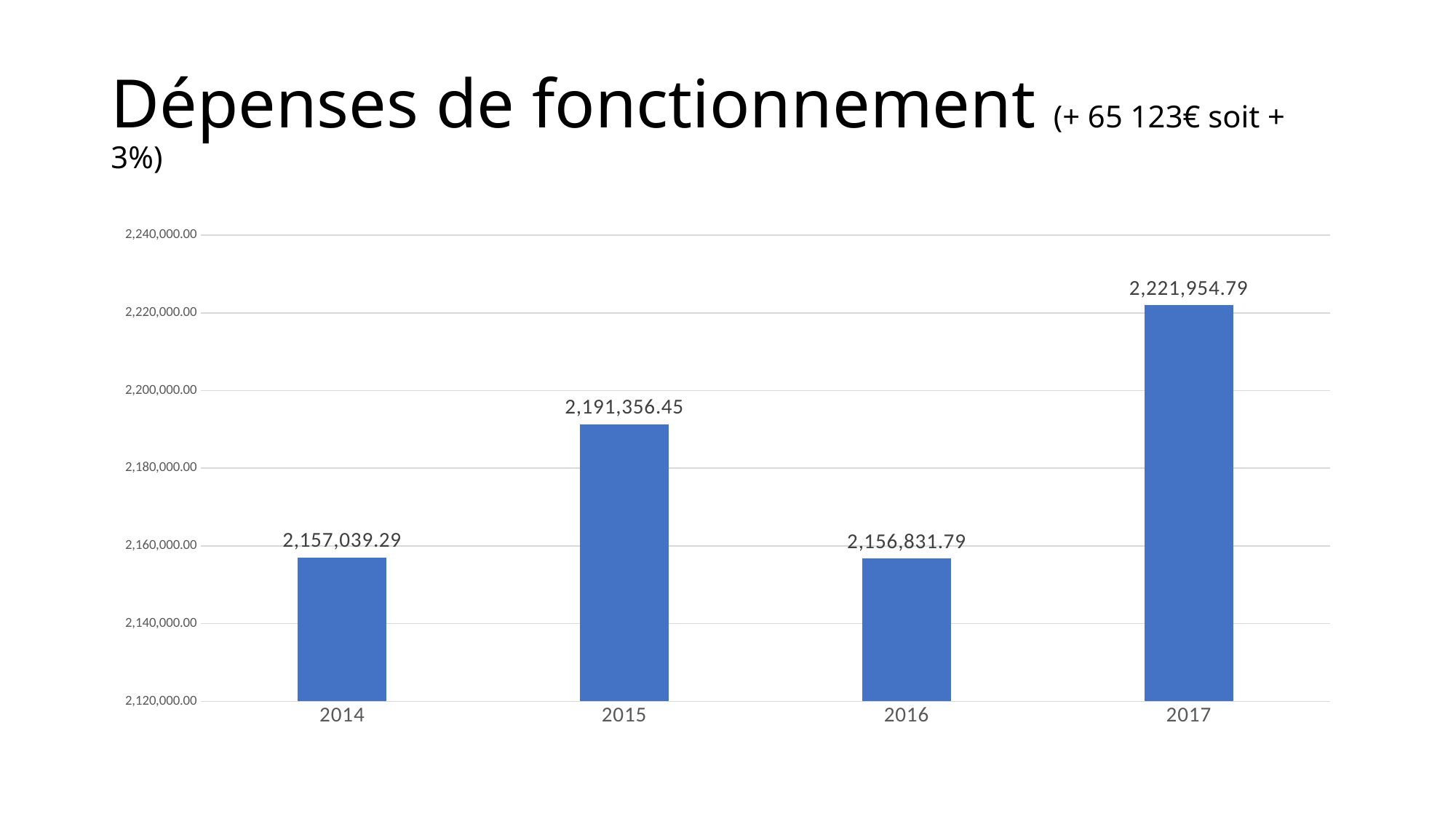
What is the value for 2016? 2,156,831.79 What is the difference between the values for 2017 and 2016? 65,123.00 What is the value for 2014? 2,157,039.29 What is the value for 2017? 2,221,954.79 Does the value rise or fall from 2016 to 2017? rise What kind of chart is shown on the slide? bar chart What is the difference between the values for 2015 and 2014? 34,317.16 Which is larger, the value for 2015 or the value for 2016? 2015 Which year has the highest value? 2017 What is the value for 2015? 2,191,356.45 How many years are shown on the x axis? 4 Is the value for 2015 greater or less than 2,180,000.00? greater